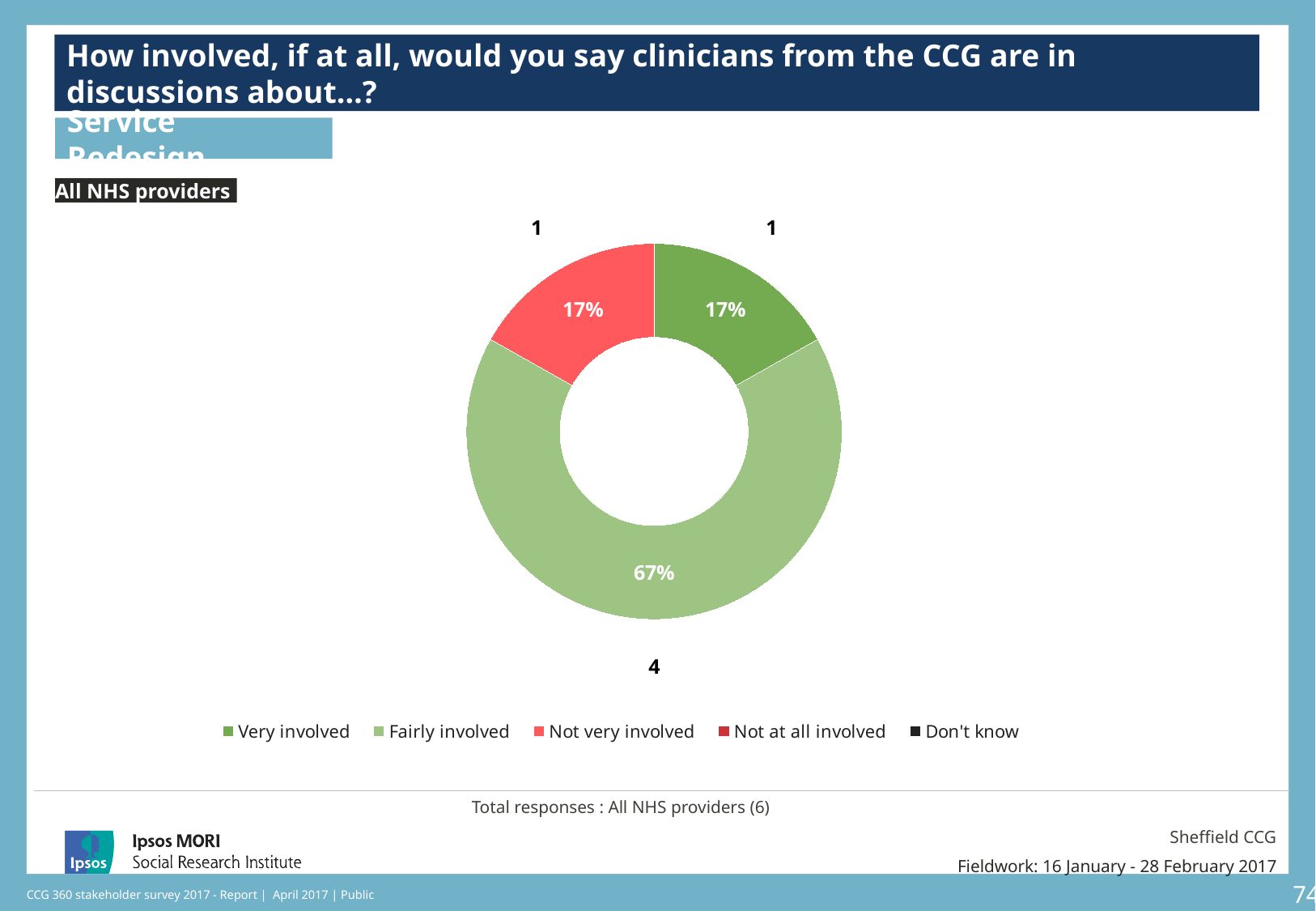
How many response categories does the legend list? 5 What percentage of respondents said clinicians from the CCG are fairly involved in discussions about service redesign? 67% Which response category has the largest share of the donut chart? Fairly involved What is the difference in percentage points between the 'Fairly involved' and 'Very involved' shares? 50 percentage points What type of chart is shown on the slide? Pie (donut) chart What percentage of respondents said clinicians from the CCG are very involved? 17% What is the total number of responses from all NHS providers shown on the slide? 6 How many slices are visible in the donut chart? 3 Is the share for 'Fairly involved' larger or smaller than the share for 'Not very involved'? larger How many respondents answered 'Fairly involved', according to the count label next to the slice? 4 What percentage of respondents said clinicians from the CCG are not very involved? 17% How many respondents answered 'Very involved', according to the count label next to the slice? 1